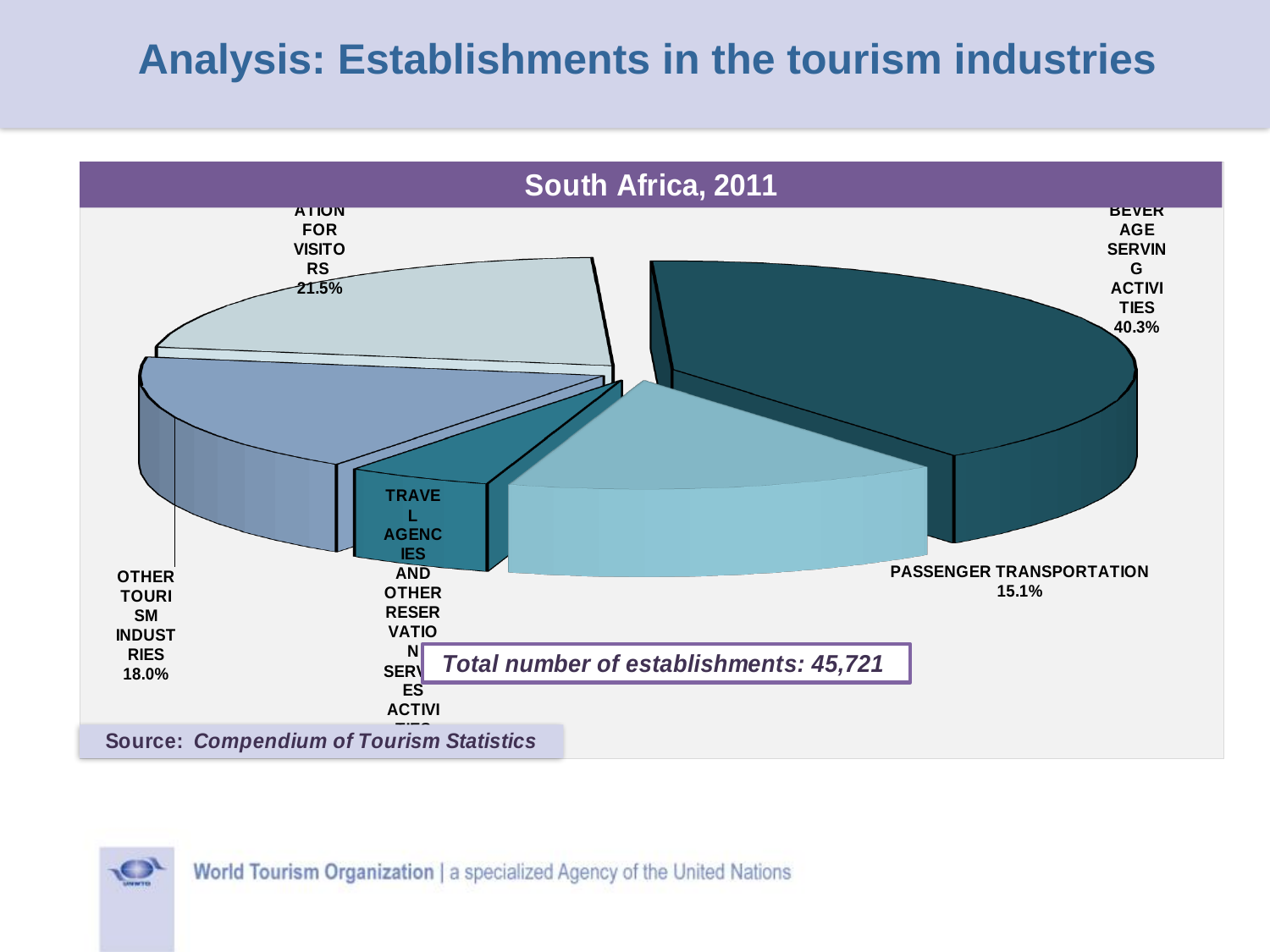
Which slice of the pie is the smallest? Travel agencies and other reservation services activities Which is larger: the share for Other tourism industries or for Passenger transportation? Other tourism industries How many slices does the pie chart have? 5 What percentage is shown for the slice labelled 'beverage serving activities'? 40.3% What is the title of the pie chart? South Africa, 2011 What type of chart is shown on the slide? Pie chart What is the difference in percentage points between Other tourism industries (18.0%) and Passenger transportation (15.1%)? 2.9 percentage points What total number of establishments is stated on the slide? 45,721 Which slice of the pie is the largest? Beverage serving activities (40.3%) What share of establishments is shown for Passenger transportation? 15.1% What percentage is shown for the slice whose label ends in 'ation for visitors'? 21.5% What share of establishments is shown for Other tourism industries? 18.0%